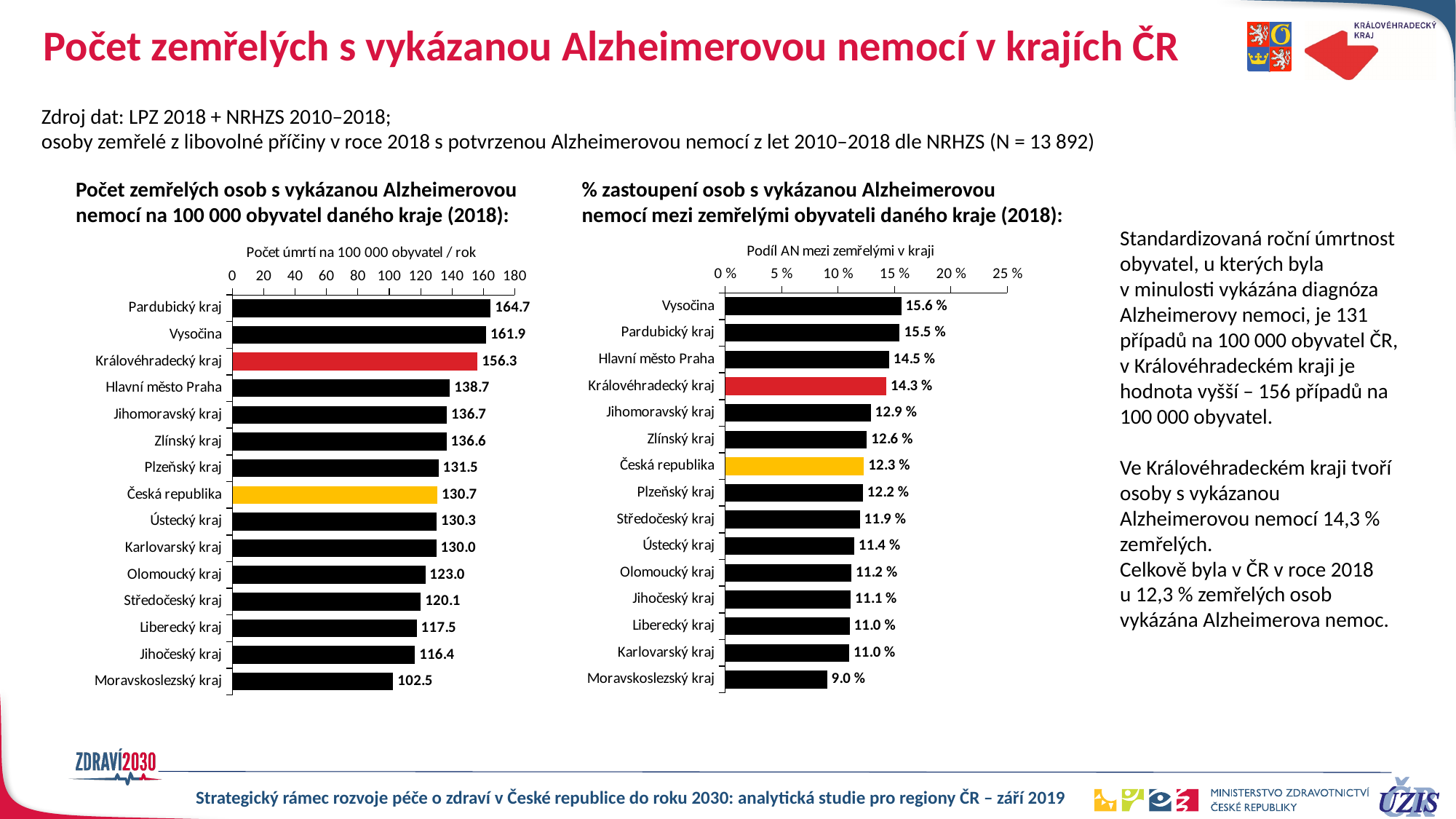
In the left chart (Počet úmrtí na 100 000 obyvatel / rok), what colour is the bar for Česká republika? Yellow In the left chart (Počet úmrtí na 100 000 obyvatel / rok), what is the value for Královéhradecký kraj? 156.3 In the left chart (Počet úmrtí na 100 000 obyvatel / rok), how many categories are shown? 15 What kind of chart is the right chart (Podíl AN mezi zemřelými v kraji)? Bar chart In the left chart (Počet úmrtí na 100 000 obyvatel / rok), what is the value for Liberecký kraj? 117.5 In the right chart (Podíl AN mezi zemřelými v kraji), which category has the highest value? Vysočina In the left chart (Počet úmrtí na 100 000 obyvatel / rok), which category has the highest value? Pardubický kraj In the right chart (Podíl AN mezi zemřelými v kraji), which is larger, Hlavní město Praha or Jihomoravský kraj? Hlavní město Praha In the right chart (Podíl AN mezi zemřelými v kraji), what is the value for Česká republika? 12.3 % In the right chart (Podíl AN mezi zemřelými v kraji), what is the difference between Vysočina and Moravskoslezský kraj? 6.6 % In the left chart (Počet úmrtí na 100 000 obyvatel / rok), which category has the lowest value? Moravskoslezský kraj In the left chart (Počet úmrtí na 100 000 obyvatel / rok), what is the difference between Pardubický kraj and Česká republika? 34.0